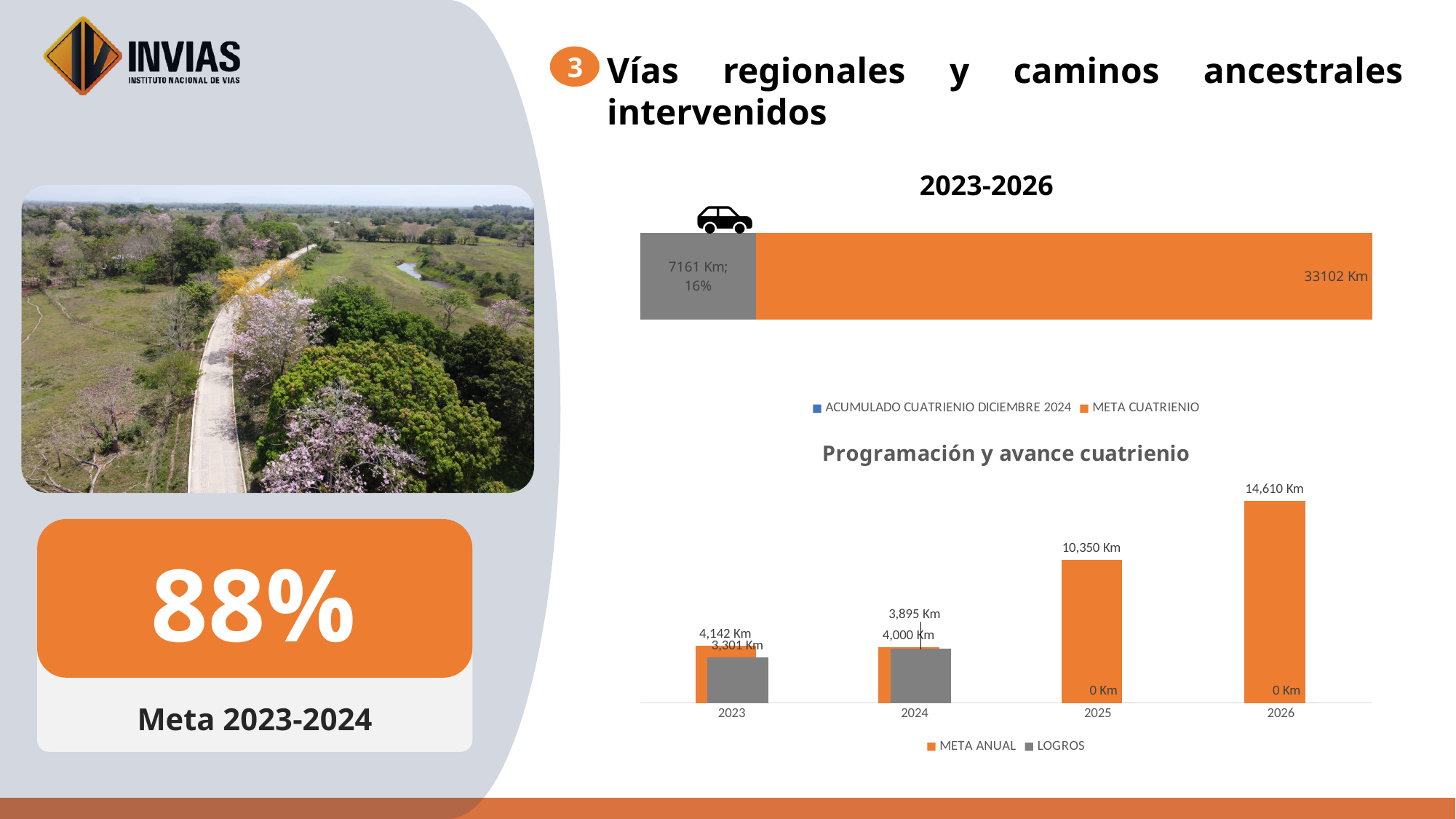
In the '2023-2026' chart at the top, what is the META CUATRIENIO value? 33102 Km In the 'Programación y avance cuatrienio' chart, which year has the highest META ANUAL? 2026 How many series does the legend of the 'Programación y avance cuatrienio' chart list? 2 In the 'Programación y avance cuatrienio' chart, what is the difference between the META ANUAL and LOGROS values for 2023? 841 Km In the 'Programación y avance cuatrienio' chart, is the META ANUAL for 2025 larger or smaller than the META ANUAL for 2026? smaller In the '2023-2026' chart at the top, what percentage is shown for ACUMULADO CUATRIENIO DICIEMBRE 2024? 16% How many years are shown on the x axis of the 'Programación y avance cuatrienio' chart? 4 In the 'Programación y avance cuatrienio' chart, what is the LOGROS value for 2023? 3,301 Km What kind of chart is the 'Programación y avance cuatrienio' chart? bar chart In the 'Programación y avance cuatrienio' chart, what is the META ANUAL value for 2026? 14,610 Km In the 'Programación y avance cuatrienio' chart, what is the LOGROS value for 2024? 3,895 Km In the 'Programación y avance cuatrienio' chart, which year has the lowest META ANUAL? 2024